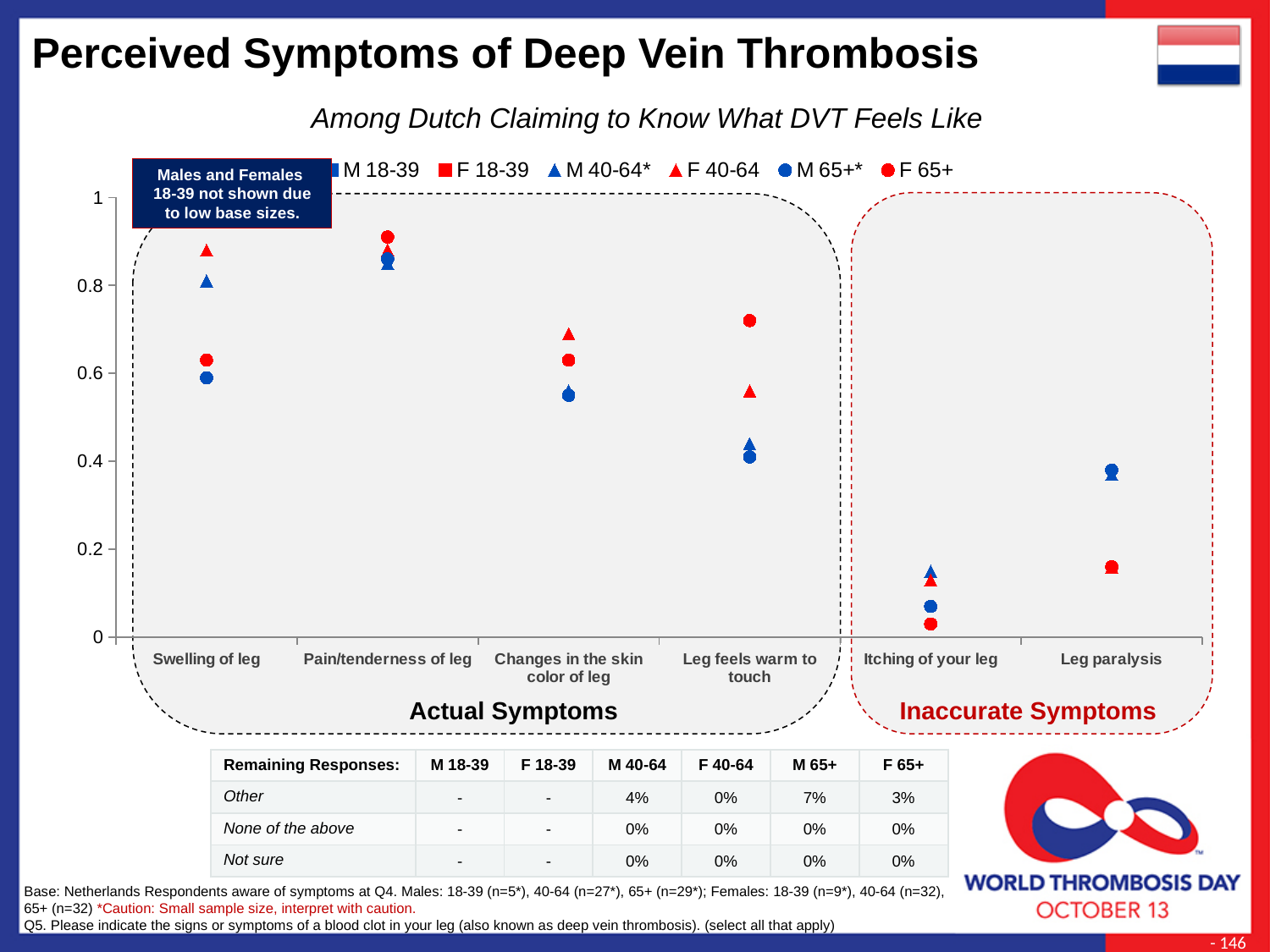
For 'Leg feels warm to touch', which is higher: F 65+ or M 65+? F 65+ Which symptom category has the highest plotted values overall? Pain/tenderness of leg How many symptom categories are plotted along the x axis? 6 Is the value for F 65+ on 'Pain/tenderness of leg' greater or less than 0.8? greater Is the value for F 65+ on 'Itching of your leg' greater or less than 0.2? less How many series does the chart legend list? 6 What kind of chart is shown on the slide? Scatter (dot) chart Which symptom category has the lowest plotted values overall? Itching of your leg Is the value for F 65+ on 'Leg feels warm to touch' greater or less than 0.6? greater Which two symptom categories are grouped under 'Inaccurate Symptoms'? Itching of your leg and Leg paralysis